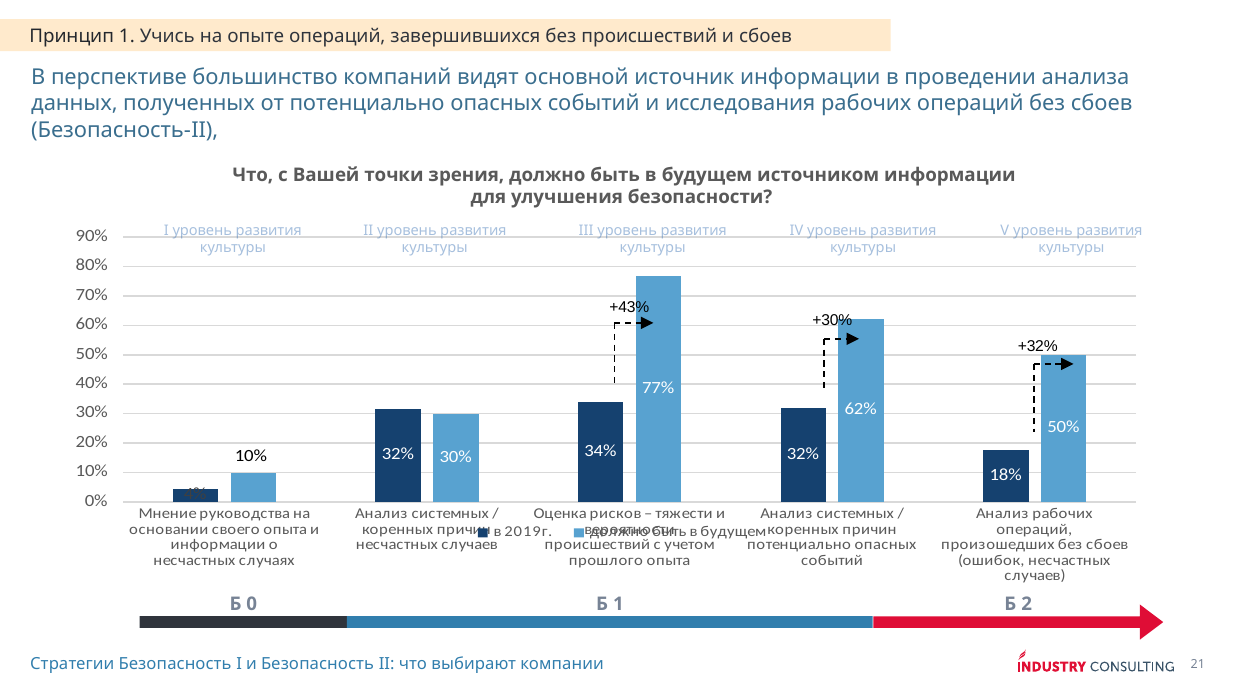
What is the 'должно быть в будущем' value for 'Оценка рисков – тяжести и вероятности происшествий с учетом прошлого опыта'? 77% How many series does the chart's legend list? 2 By how much does the 'должно быть в будущем' value exceed the 'в 2019г.' value for 'Анализ системных / коренных причин потенциально опасных событий'? 30% For 'Анализ системных / коренных причин несчастных случаев', which is larger: the 'в 2019г.' value or the 'должно быть в будущем' value? в 2019г. Which category has the lowest 'должно быть в будущем' value? Мнение руководства на основании своего опыта и информации о несчастных случаях What is the 'в 2019г.' value for 'Оценка рисков – тяжести и вероятности происшествий с учетом прошлого опыта'? 34% What kind of chart is shown on the slide? bar chart Which category has the highest 'должно быть в будущем' value? Оценка рисков – тяжести и вероятности происшествий с учетом прошлого опыта What is the 'в 2019г.' value for 'Анализ рабочих операций, произошедших без сбоев'? 18% What is the title of the chart? Что, с Вашей точки зрения, должно быть в будущем источником информации для улучшения безопасности? How many categories are shown along the x axis of the chart? 5 Is the 'в 2019г.' value for 'Мнение руководства на основании своего опыта и информации о несчастных случаях' greater or less than 10%? less